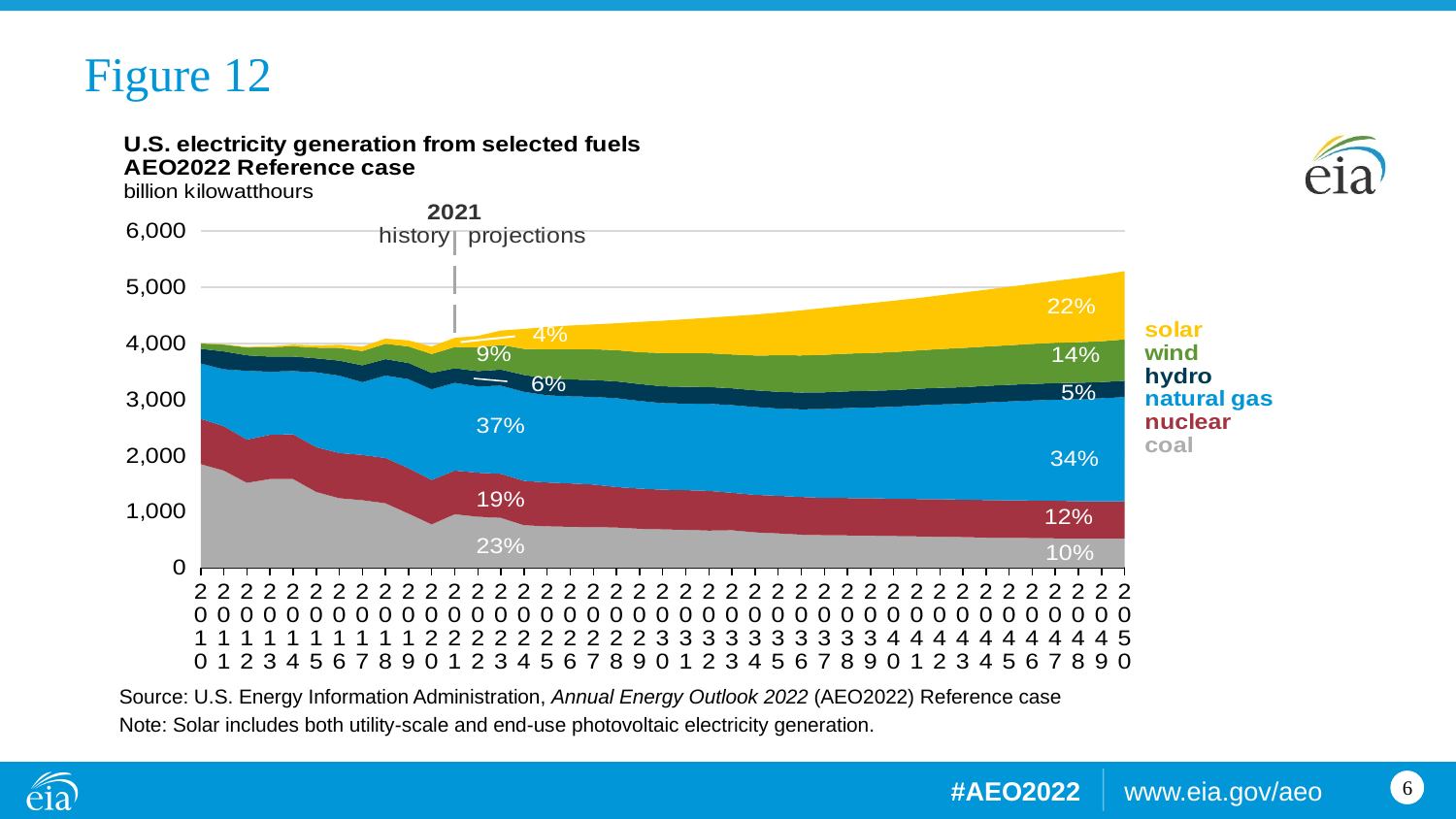
What share is labeled for natural gas at the right end of the chart (2050)? 34% What share is labeled for wind near 2021? 9% What share of U.S. electricity generation is labeled for solar at the right end of the chart (2050)? 22% Which fuel has the smallest labeled share near 2021? solar Which fuel has the largest labeled share at the right end of the chart (2050)? natural gas At the right end of the chart (2050), which labeled share is larger: wind or nuclear? wind What unit is used on the y-axis of the chart? billion kilowatthours What type of chart is shown on the slide? stacked area chart How many fuel series does the legend list? 6 By how many percentage points does the labeled coal share change from near 2021 (23%) to 2050 (10%)? 13 percentage points Is total electricity generation in 2050 greater or less than 5,000 billion kilowatthours? greater What share is labeled for coal near 2021? 23%